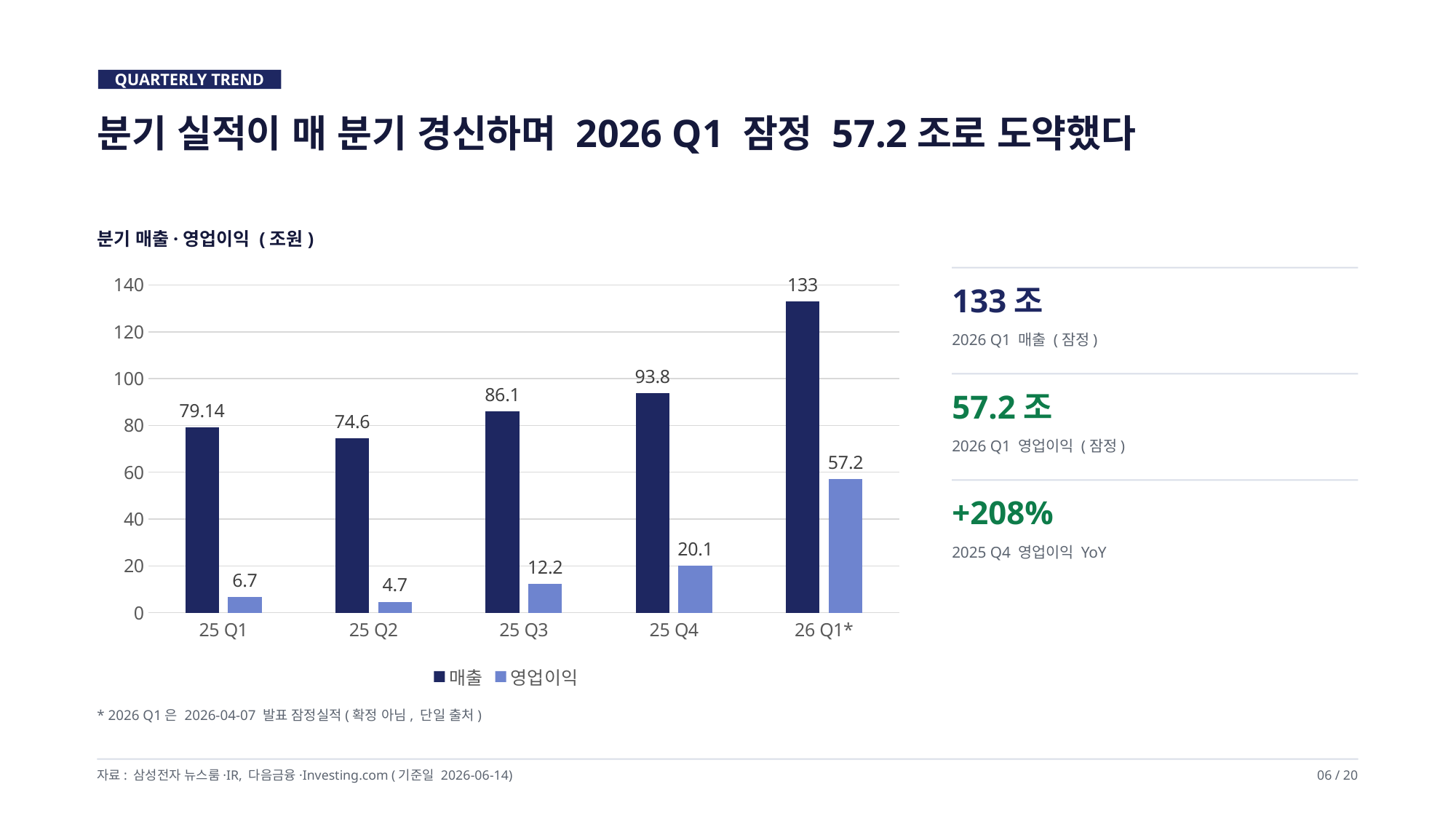
Which is larger, the 매출 for 25 Q1 or the 매출 for 25 Q2? 25 Q1 How many series does the legend list? 2 What kind of chart is shown on the slide? bar chart What is the 매출 value for 25 Q3? 86.1 Is the 매출 value for 25 Q4 greater or less than 100? less What is the difference between the 영업이익 for 26 Q1* and 25 Q4? 37.1 What is the 매출 value for 26 Q1*? 133 How many quarters are shown on the x axis? 5 Does the 영업이익 rise or fall from 25 Q2 to 26 Q1*? rise What is the 영업이익 value for 25 Q4? 20.1 Which quarter has the lowest 매출? 25 Q2 Which quarter has the highest 영업이익? 26 Q1*